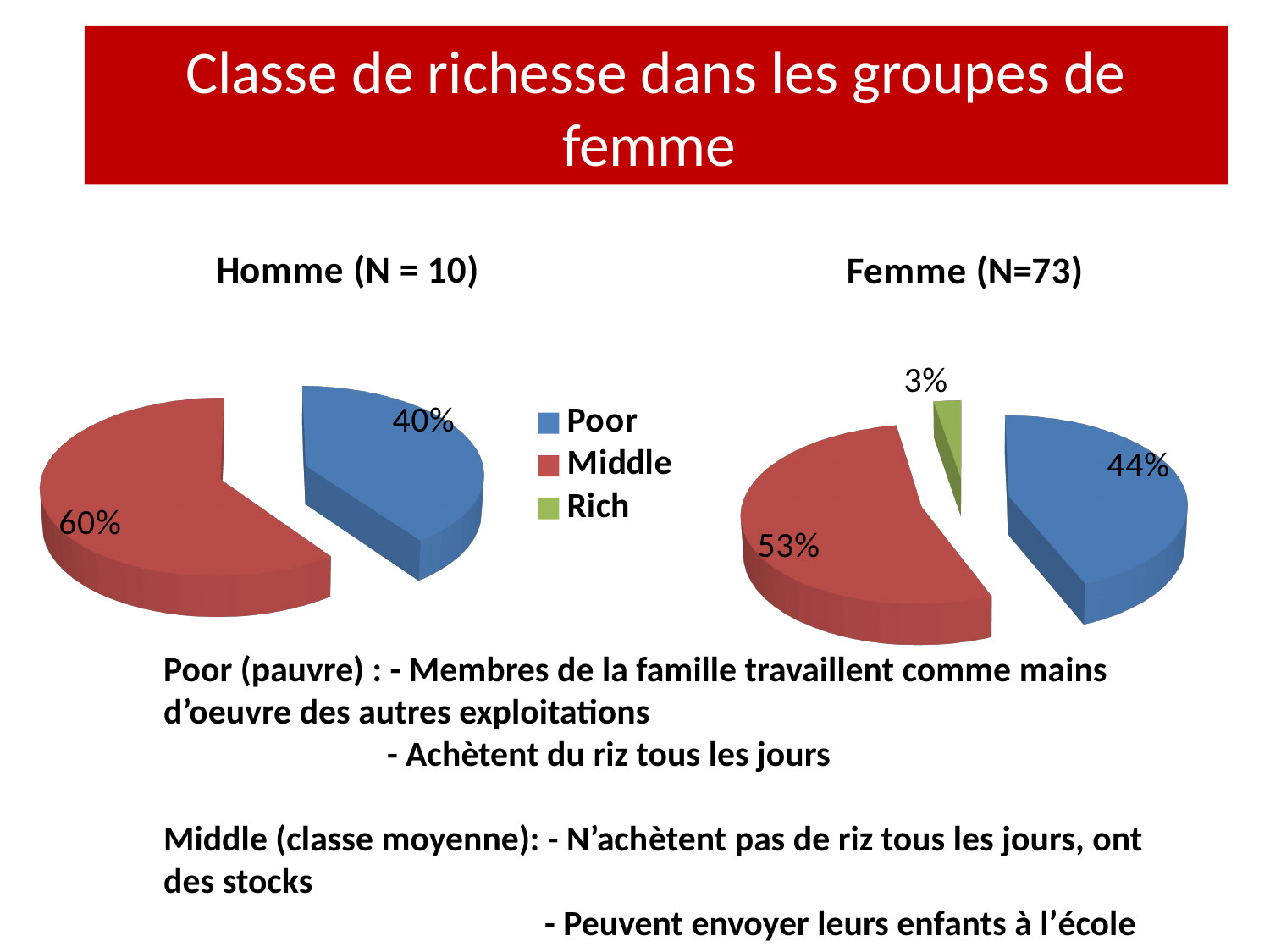
In the Femme (N=73) chart, what is the difference between the Middle and Poor shares? 9% In the Femme (N=73) chart, what share of the pie is Poor? 44% In the Femme (N=73) chart, which category has the largest slice? Middle In the Homme (N = 10) chart, what share of the pie is Poor? 40% How many series does the legend list? 3 In the Femme (N=73) chart, what share of the pie is Rich? 3% In the Homme (N = 10) chart, what is the difference between the Middle and Poor shares? 20% In the Femme (N=73) chart, what share of the pie is Middle? 53% In the Homme (N = 10) chart, what share of the pie is Middle? 60% In the Femme (N=73) chart, which category has the smallest slice? Rich What type of chart is used on this slide? Pie chart In the Homme (N = 10) chart, which category has the largest slice? Middle